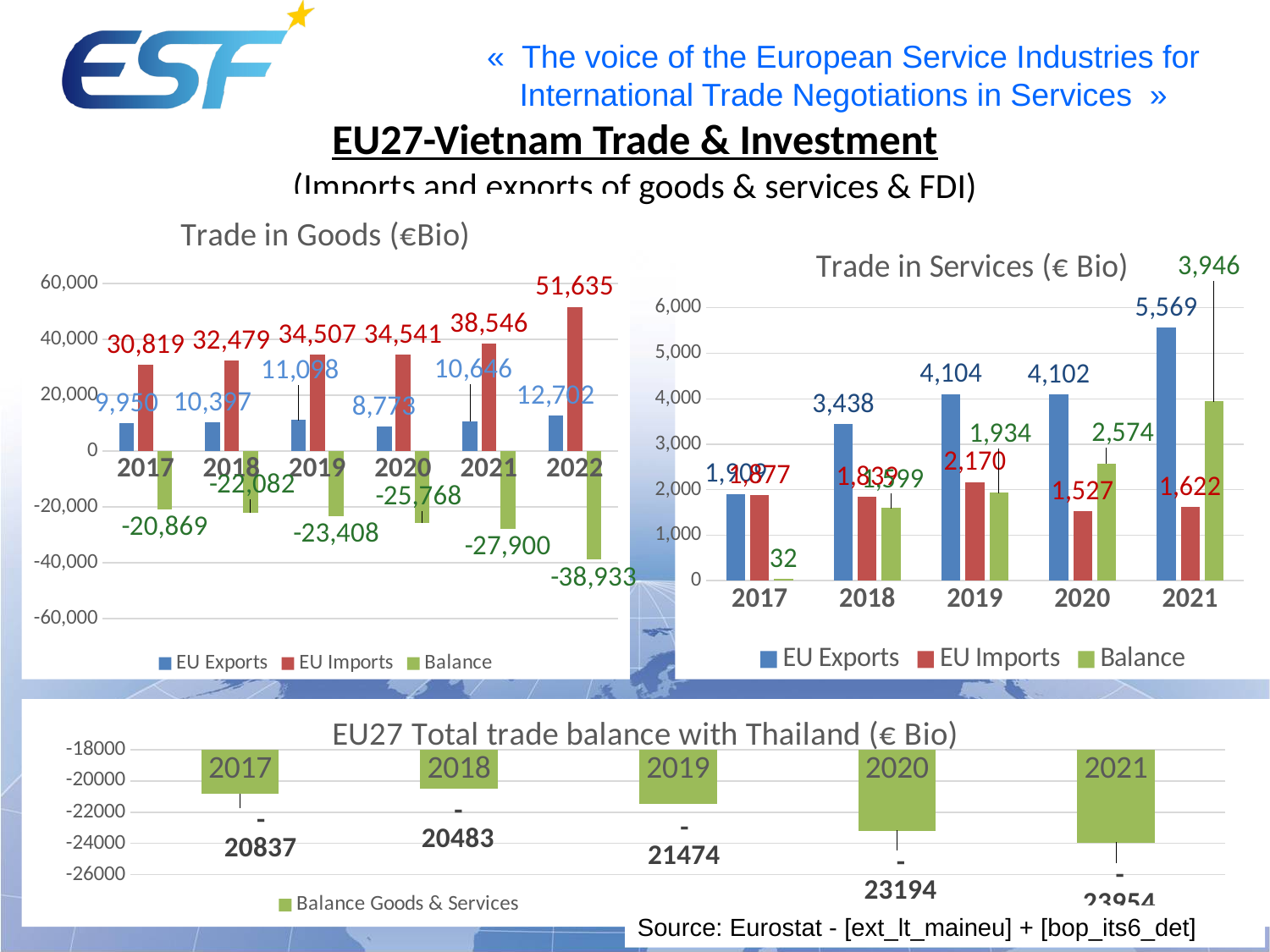
In the Trade in Goods chart, do the EU Imports values rise or fall from 2017 to 2022? rise In the Trade in Services chart, what is the value of EU Exports for 2021? 5,569 In the Trade in Goods chart, what is the Balance value for 2021? -27,900 In the EU27 Total trade balance with Thailand chart, what is the value for 2018? -20483 In the Trade in Goods chart, which year has the lowest EU Exports value? 2020 In the Trade in Goods chart, how many years are shown on the x axis? 6 In the Trade in Services chart, how many series does the legend list? 3 In the Trade in Services chart, which year has the highest Balance value? 2021 In the Trade in Goods chart, which year has the highest EU Imports value? 2022 In the Trade in Services chart, what is the Balance value for 2020? 2,574 In the Trade in Goods chart, what is the value of EU Imports for 2022? 51,635 In the Trade in Goods chart, what is the difference between EU Imports in 2022 and EU Imports in 2021? 13,089